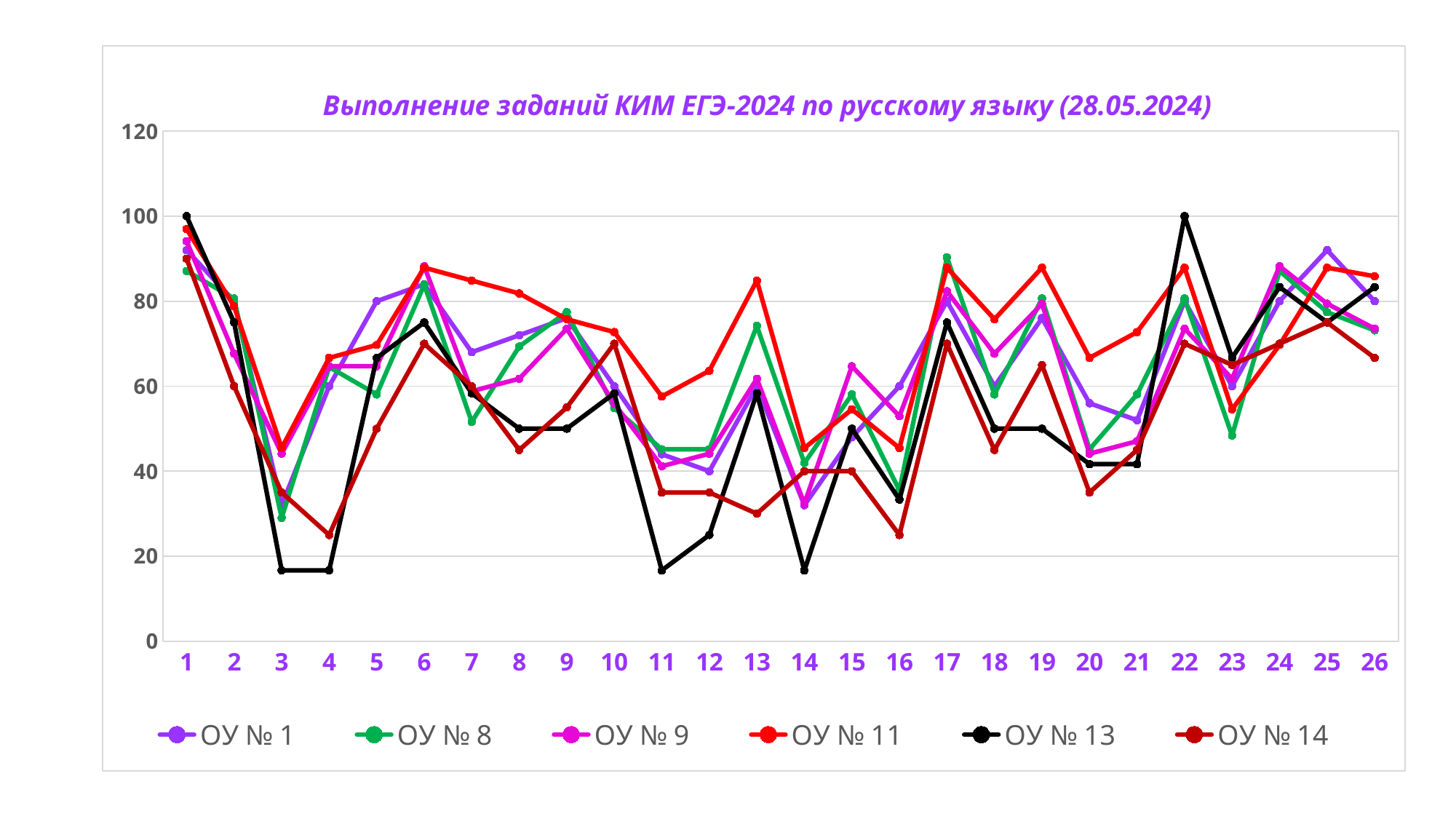
Is the value for ОУ № 13 at task 3 greater or less than 20? less Is the value for ОУ № 14 at task 4 greater or less than 40? less What is the value for ОУ № 13 at task 22? 100 What is the title of the chart? Выполнение заданий КИМ ЕГЭ-2024 по русскому языку (28.05.2024) How many series does the legend list? 6 Is the value for ОУ № 11 at task 13 greater or less than 80? greater Which series has the lowest value at task 11? ОУ № 13 How many task numbers are shown along the x axis? 26 What kind of chart is shown on the slide? line chart At task 16, which is larger: the value for ОУ № 1 or the value for ОУ № 14? ОУ № 1 Which series has the highest value at task 22? ОУ № 13 What is the value for ОУ № 13 at task 1? 100